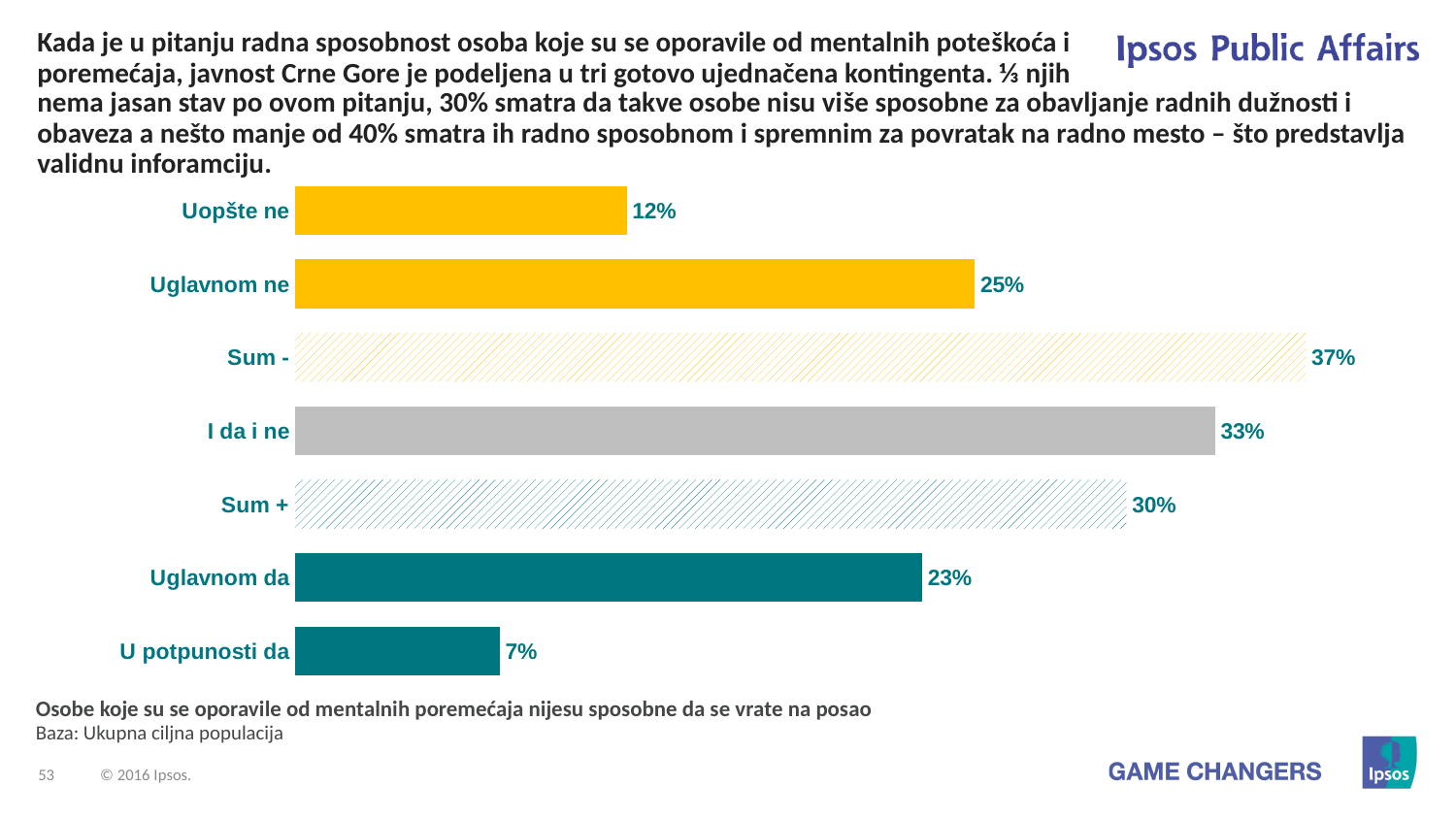
Which category has the highest value? Sum - What is the value for "Sum -"? 37% What is the value for "U potpunosti da"? 7% What kind of chart is shown on the slide? Bar chart What is the statement shown below the chart that respondents were asked about? Osobe koje su se oporavile od mentalnih poremećaja nijesu sposobne da se vrate na posao What is the value for "Uglavnom ne"? 25% What is the difference between "Uglavnom ne" and "Uopšte ne"? 13% What is the difference between "Uglavnom da" and "U potpunosti da"? 16% How many categories are shown in the chart? 7 Which is larger, "Sum -" or "Sum +"? Sum - Which category has the lowest value? U potpunosti da What is the value for "I da i ne"? 33%